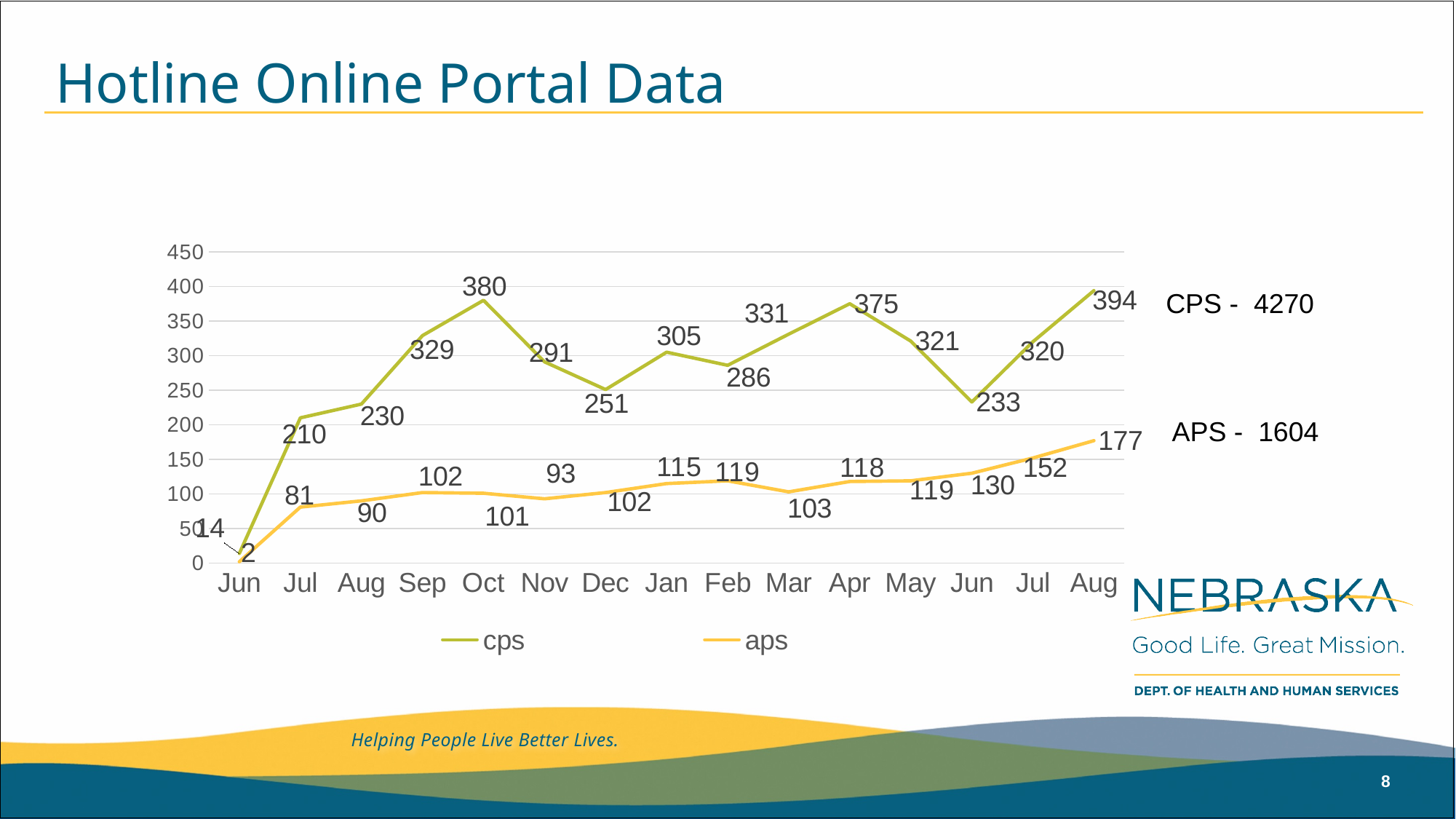
What kind of chart is shown on the slide? Line chart What is the cps value for Oct? 380 Which month has the lowest aps value? Jun (the first month) How many series does the legend list? 2 Which is larger, the cps value for Mar or the cps value for Apr? Apr What is the difference between the cps values for Oct and Nov? 89 What is the difference between the aps values for the final Aug and the final Jul? 25 What is the aps value for Dec? 102 How many months are plotted on the x axis? 15 What total is shown for CPS in the text to the right of the chart? 4270 What is the cps value for Apr? 375 Which month has the highest cps value? Aug (the last month)